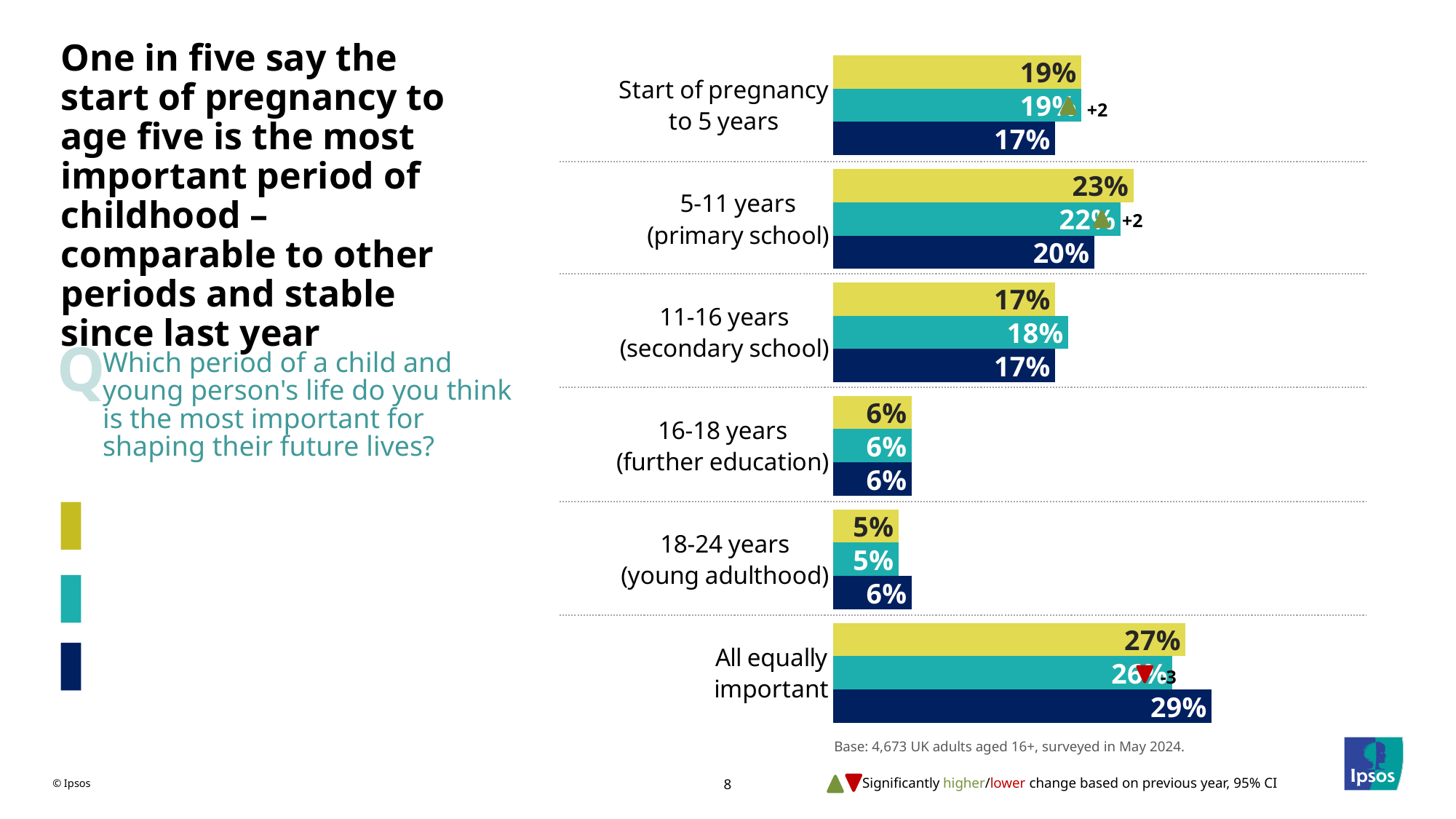
Which category has the highest yellow bar value? All equally important Which category has the lowest teal bar value? 18-24 years (young adulthood) What is the value of the navy bar for 'All equally important'? 29% What is the value of the teal bar for '11-16 years (secondary school)'? 18% How many series (colour swatches) does the legend show? 3 How many categories (periods) are shown on the chart? 6 What kind of chart is shown on the slide? Bar chart What is the value of the navy bar for '5-11 years (primary school)'? 20% What change is marked next to the teal bar for 'All equally important'? -3 What is the difference between the yellow bar values for '5-11 years (primary school)' and '11-16 years (secondary school)'? 6% Which is larger: the navy bar for 'All equally important' or the navy bar for '5-11 years (primary school)'? All equally important What is the value of the yellow bar for 'Start of pregnancy to 5 years'? 19%